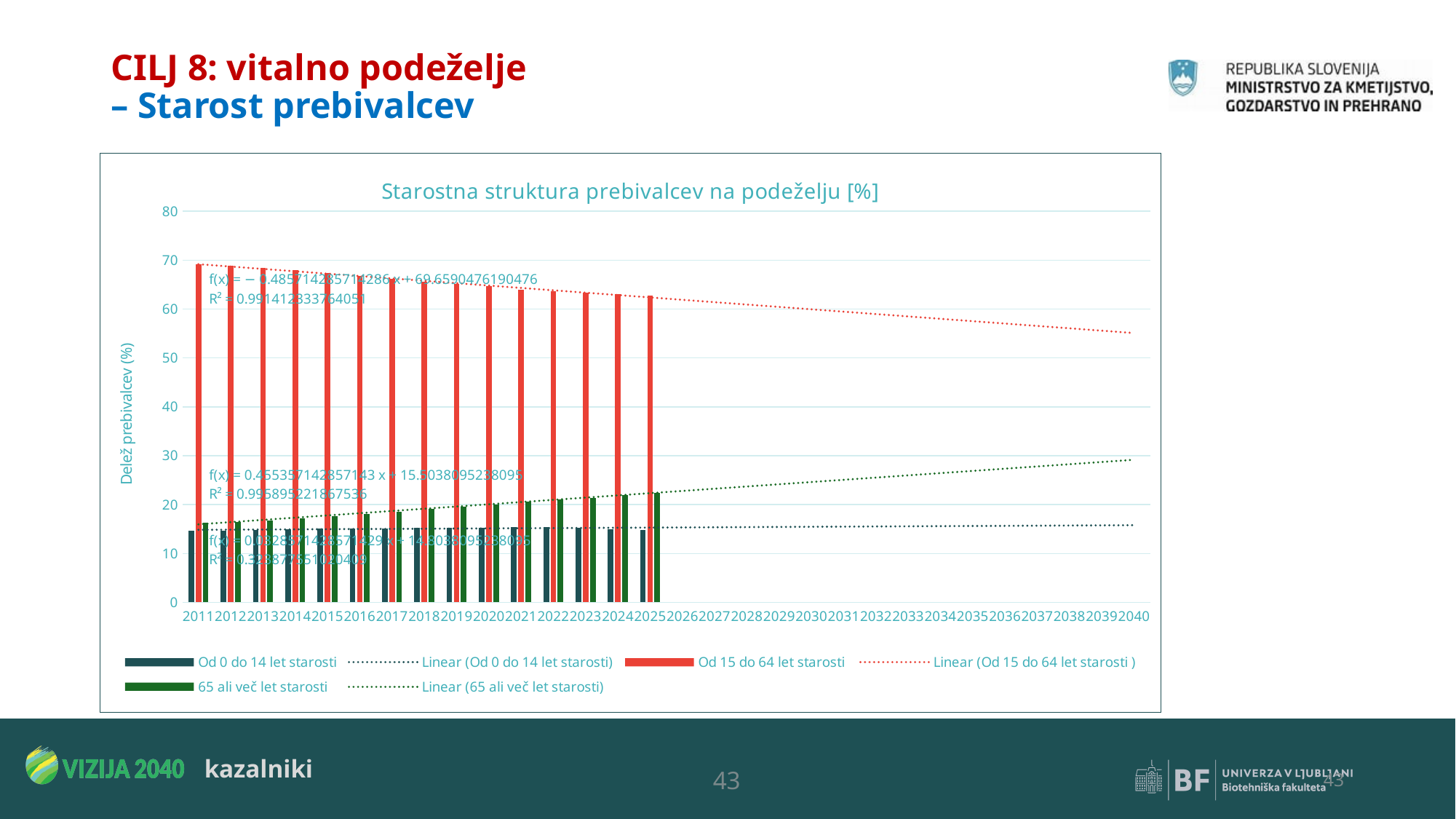
Do the bars for 'Od 15 do 64 let starosti' rise or fall from 2011 to 2025? fall Do the bars for '65 ali več let starosti' rise or fall from 2011 to 2025? rise What is the label of the vertical axis? Delež prebivalcev (%) How many entries does the chart legend list? 6 Which series has the highest bar in 2020? Od 15 do 64 let starosti What kind of chart is shown on the slide? bar chart What is the title of the chart? Starostna struktura prebivalcev na podeželju [%] Is the value for 'Od 0 do 14 let starosti' in 2011 greater or less than 20? less Is the value for '65 ali več let starosti' in 2025 greater or less than 20? greater Is the value for 'Od 15 do 64 let starosti' in 2011 greater or less than 60? greater In 2025, which is larger: '65 ali več let starosti' or 'Od 0 do 14 let starosti'? 65 ali več let starosti